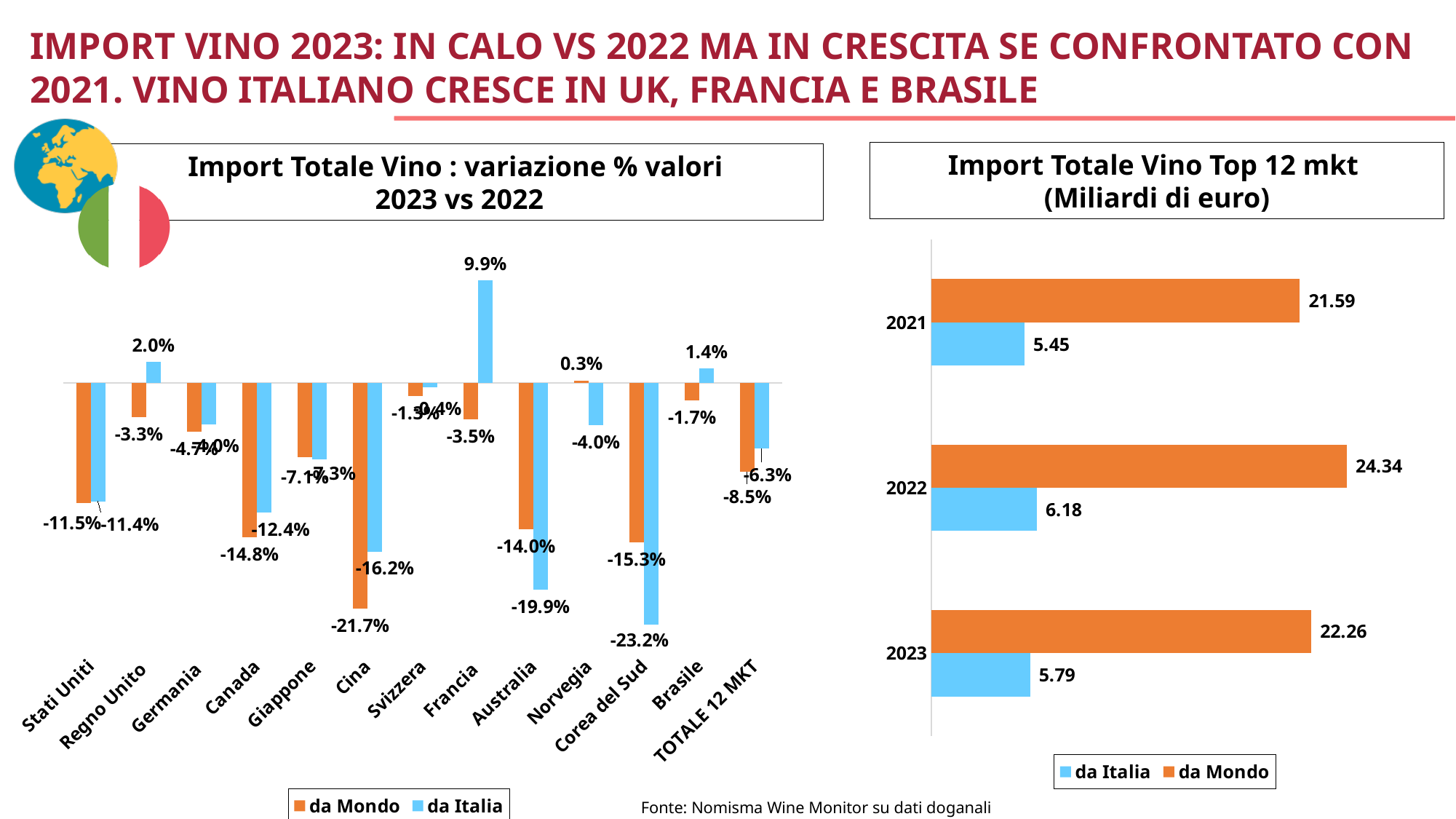
In the chart 'Import Totale Vino : variazione % valori 2023 vs 2022', what is the 'da Mondo' value for Cina? -21.7% In the chart 'Import Totale Vino : variazione % valori 2023 vs 2022', what is the value for Francia in the 'da Italia' series? 9.9% In the chart 'Import Totale Vino Top 12 mkt (Miliardi di euro)', what is the difference between the 'da Mondo' values for 2022 and 2023? 2.08 In the chart 'Import Totale Vino : variazione % valori 2023 vs 2022', how many categories are shown on the x axis? 13 In the chart 'Import Totale Vino : variazione % valori 2023 vs 2022', what is the 'da Mondo' value for TOTALE 12 MKT? -8.5% In the chart 'Import Totale Vino : variazione % valori 2023 vs 2022', which category has the lowest 'da Italia' value? Corea del Sud In the chart 'Import Totale Vino Top 12 mkt (Miliardi di euro)', what is the 'da Mondo' value for 2022? 24.34 What type of chart is 'Import Totale Vino Top 12 mkt (Miliardi di euro)'? Bar chart In the chart 'Import Totale Vino : variazione % valori 2023 vs 2022', which category has the highest 'da Italia' value? Francia In the chart 'Import Totale Vino Top 12 mkt (Miliardi di euro)', which year has the highest 'da Italia' value? 2022 In the chart 'Import Totale Vino Top 12 mkt (Miliardi di euro)', what is the 'da Italia' value for 2023? 5.79 In the chart 'Import Totale Vino : variazione % valori 2023 vs 2022', which is larger for Australia: the 'da Mondo' value or the 'da Italia' value? da Mondo